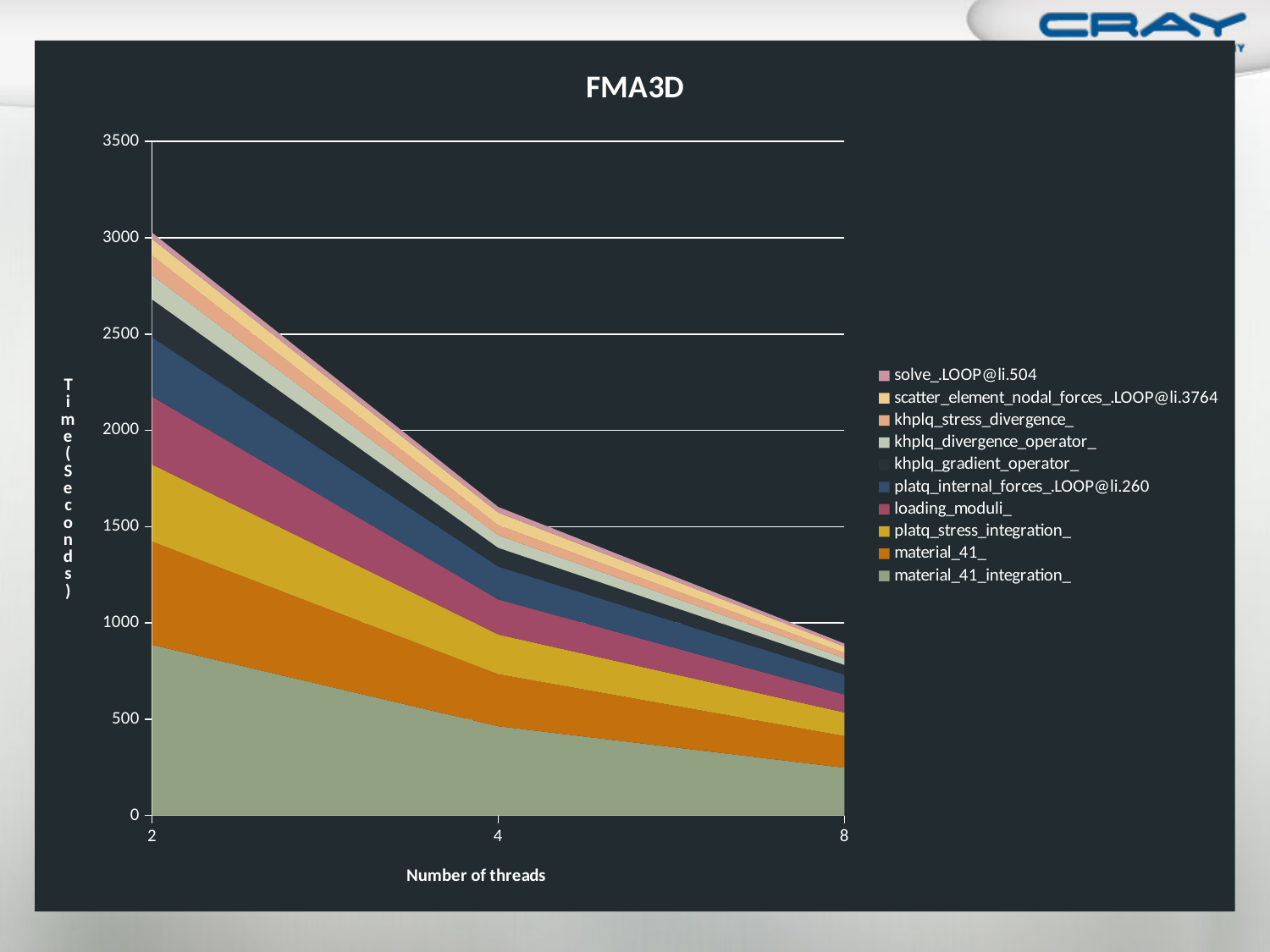
At which number of threads is the total time highest? 2 How many thread counts are plotted along the x axis? 3 What is the title of the chart? FMA3D Is the value for material_41_integration_ at 2 threads greater or less than 1000? less At which number of threads is the total time lowest? 8 What kind of chart is shown on the slide? stacked area chart Is the total time at 4 threads greater or less than 1500? greater What is the label of the x axis? Number of threads Is the total time at 8 threads greater or less than 1000? less Which has the larger total time, 2 threads or 8 threads? 2 threads Does the total time rise or fall as the number of threads increases? fall How many series does the legend list? 10